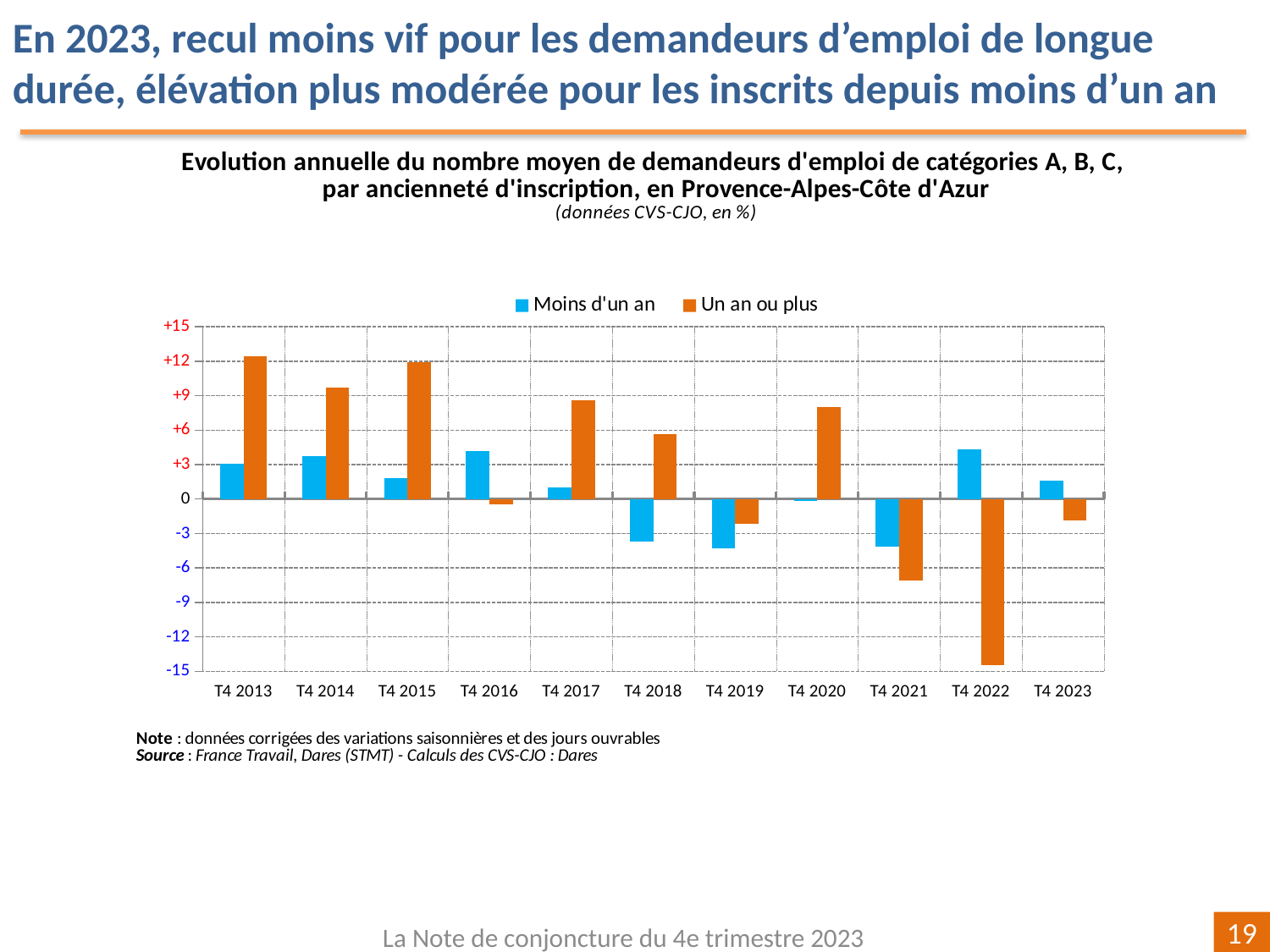
Which quarter has the lowest value for the 'Un an ou plus' series? T4 2022 How many quarters (categories) are shown on the x axis? 11 Which series is shown in orange in the legend? Un an ou plus Is the value for 'Un an ou plus' in T4 2013 greater or less than +12? greater In T4 2013, which series has the larger value, 'Moins d'un an' or 'Un an ou plus'? Un an ou plus In T4 2022, which series has the larger value, 'Moins d'un an' or 'Un an ou plus'? Moins d'un an Is the value for 'Un an ou plus' in T4 2022 greater or less than -12? less Is the value for 'Un an ou plus' in T4 2021 greater or less than -6? less What kind of chart is shown on the slide? bar chart How many series does the legend list? 2